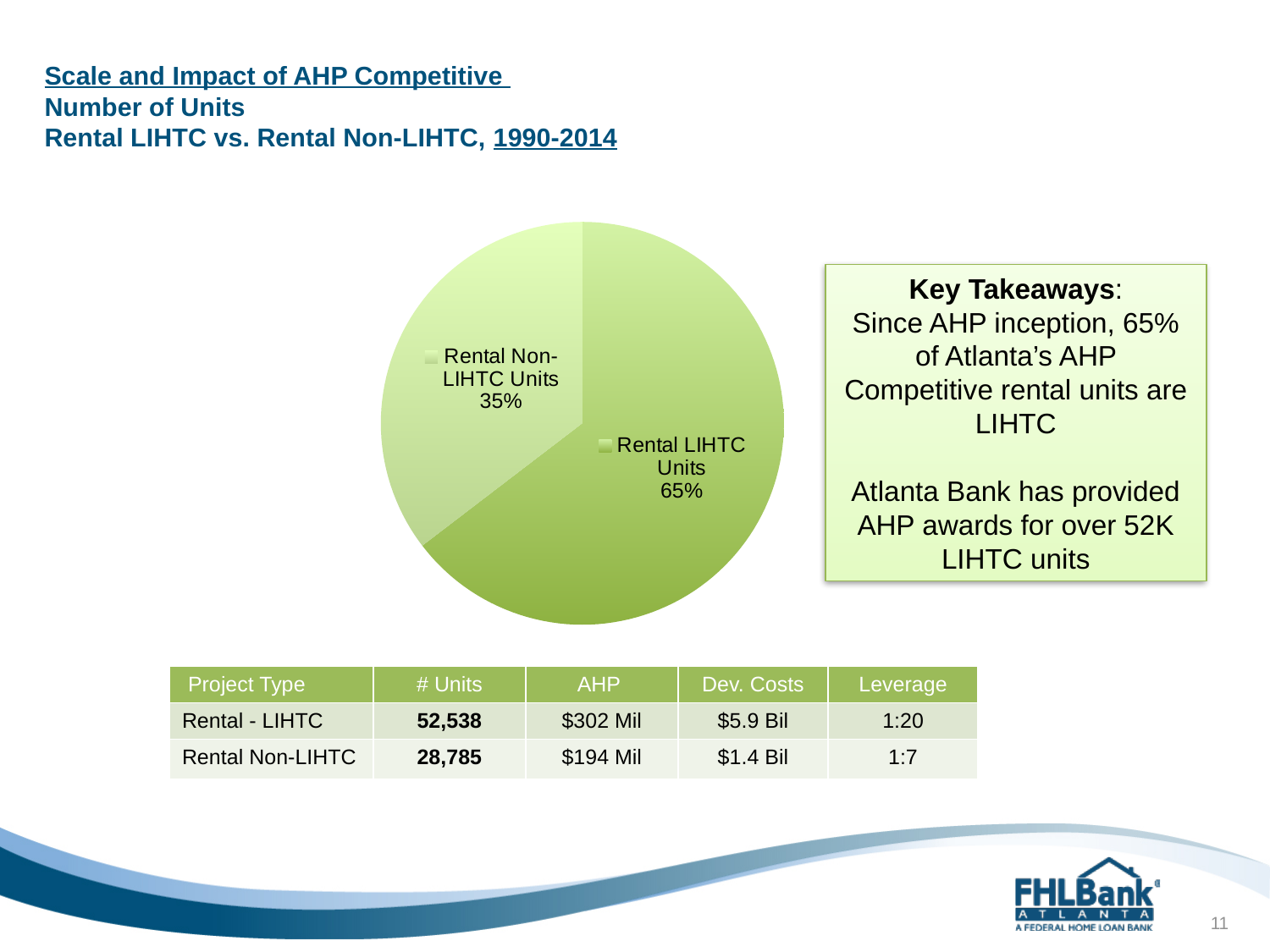
What kind of chart is shown on the slide? pie chart What share of the pie is Rental LIHTC Units? 65% Which slice of the pie is the largest? Rental LIHTC Units What time period does the slide title give for the pie chart? 1990-2014 What is the difference in percentage points between the Rental LIHTC Units slice and the Rental Non-LIHTC Units slice? 30 percentage points Is the share for Rental Non-LIHTC Units greater or less than 50%? less What colour are the slices of the pie chart? green How many slices does the pie chart have? 2 What do the two slices of the pie add up to? 100% What share of the pie is Rental Non-LIHTC Units? 35% Which slice of the pie is the smallest? Rental Non-LIHTC Units Which is larger, the Rental LIHTC Units slice or the Rental Non-LIHTC Units slice? Rental LIHTC Units